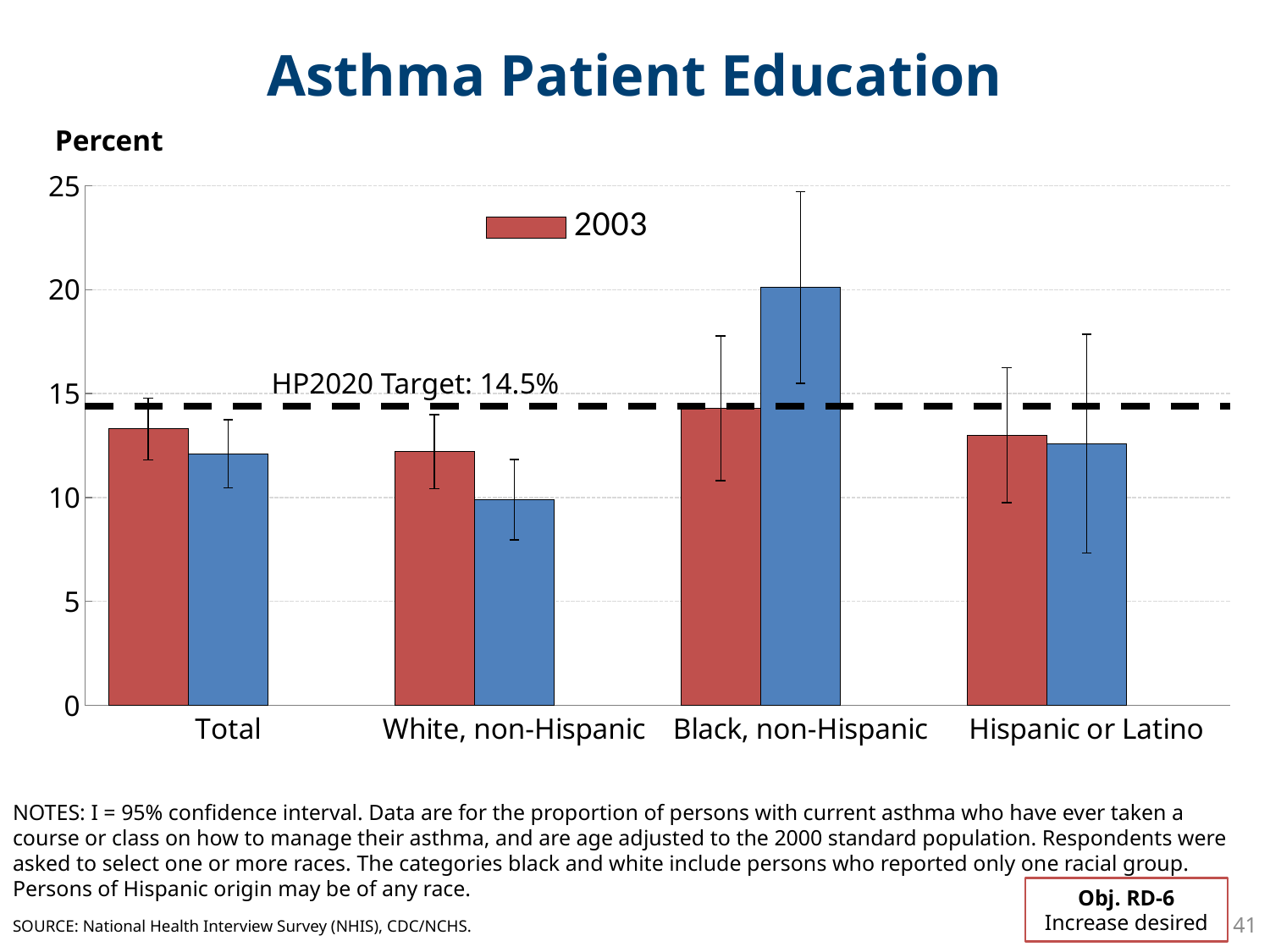
Which category has the highest blue bar? Black, non-Hispanic What is the label on the vertical axis? Percent Which year is listed in the chart legend? 2003 Is the blue bar for Black, non-Hispanic greater or less than 15? greater Is the 2003 value for Total greater or less than 15? less Is the blue bar for White, non-Hispanic greater or less than 15? less How many categories are shown along the x axis? 4 What kind of chart is shown on the slide? bar chart Which category has the lowest blue bar? White, non-Hispanic What is the HP2020 Target value shown on the chart? 14.5% For Black, non-Hispanic, which bar is taller, the 2003 bar or the blue bar? the blue bar For White, non-Hispanic, which bar is taller, the 2003 bar or the blue bar? the 2003 bar